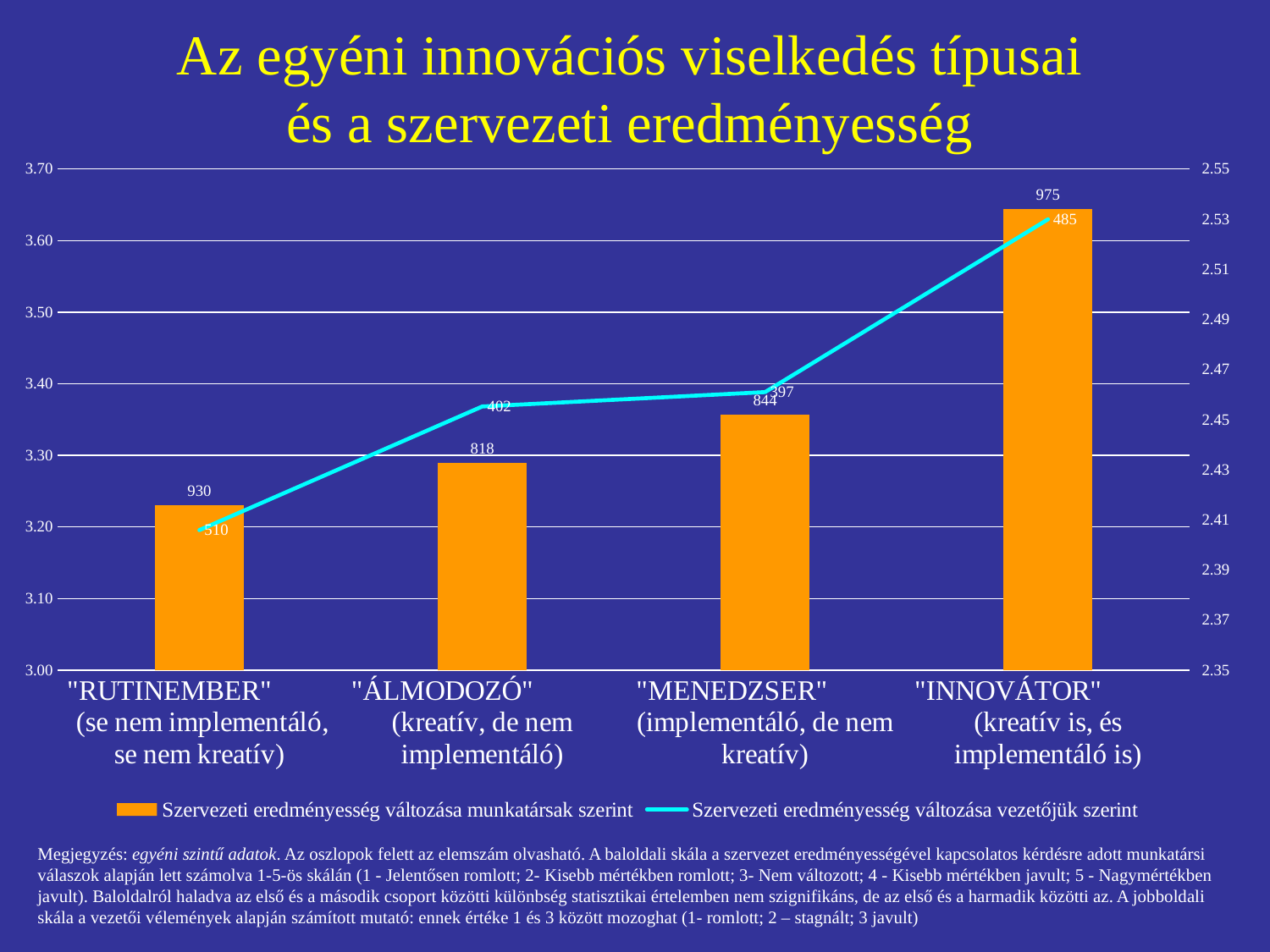
Is the orange bar for "MENEDZSER" greater or less than 3.30 on the left axis? greater Is the orange bar for "INNOVÁTOR" greater or less than 3.60 on the left axis? greater Which category has the tallest orange bar? "INNOVÁTOR" Is the cyan line point for "INNOVÁTOR" greater or less than 2.51 on the right axis? greater What number is printed above the orange bar for "RUTINEMBER"? 930 What kind of chart is shown on the slide? Combined bar and line chart Which category has the highest point on the cyan line? "INNOVÁTOR" How many series does the chart legend list? 2 Which orange bar is taller, "MENEDZSER" or "ÁLMODOZÓ"? "MENEDZSER" How many categories are shown on the x axis of the chart? 4 Which category has the shortest orange bar? "RUTINEMBER" Which category has the lowest point on the cyan line? "RUTINEMBER"